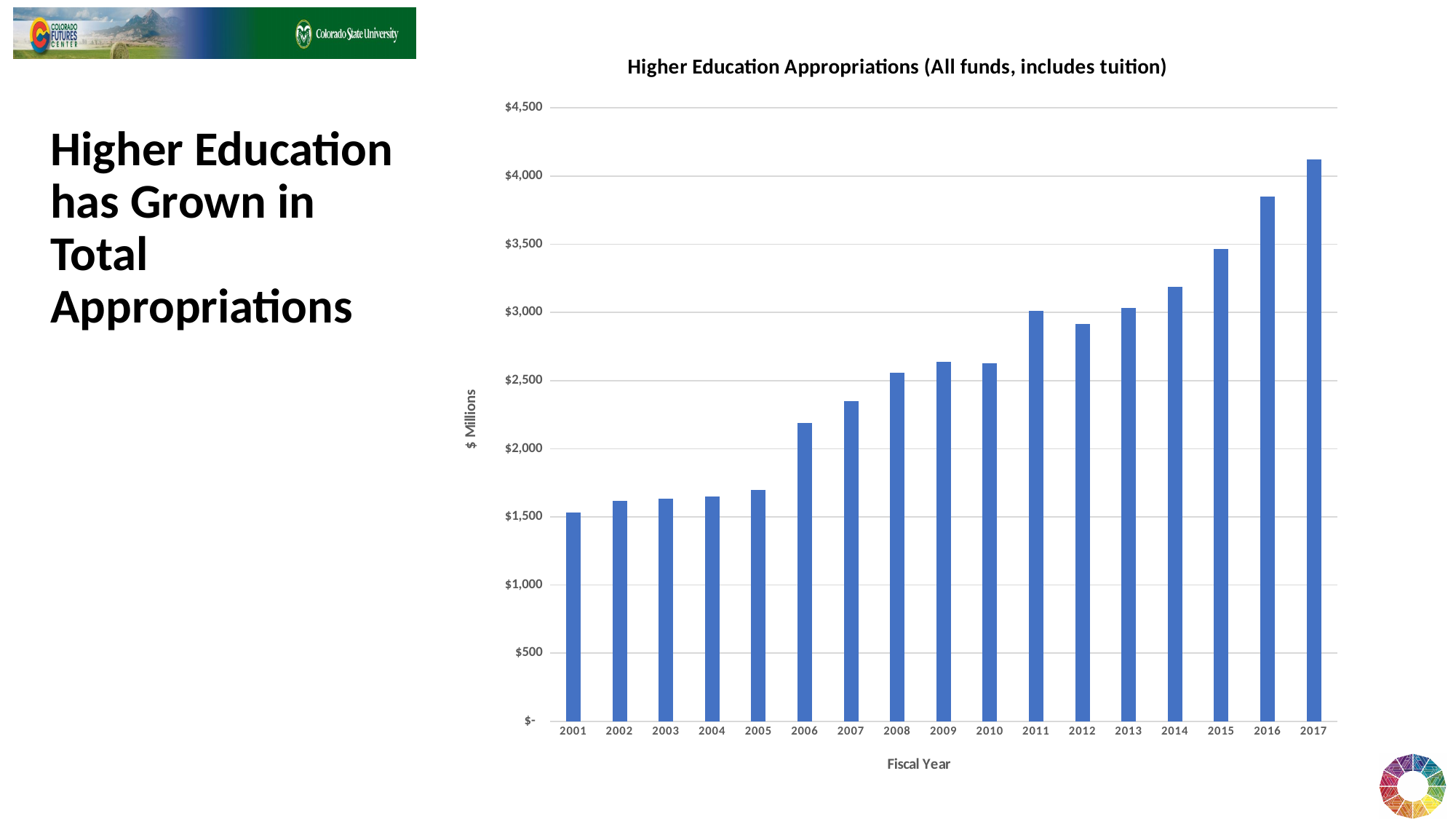
What is the label of the vertical axis? $ Millions Is the value for 2017 greater or less than $4,000? greater What is the title of the chart? Higher Education Appropriations (All funds, includes tuition) How many fiscal years are plotted on the chart? 17 Is the value for 2006 greater or less than $2,000? greater Which fiscal year has the highest appropriations? 2017 Do appropriations generally rise or fall from 2001 to 2017? Rise Is the value for 2012 greater or less than $3,000? less Which fiscal year has the lowest appropriations? 2001 What kind of chart is shown on the slide? Bar chart Which is larger, the value for 2011 or the value for 2012? 2011